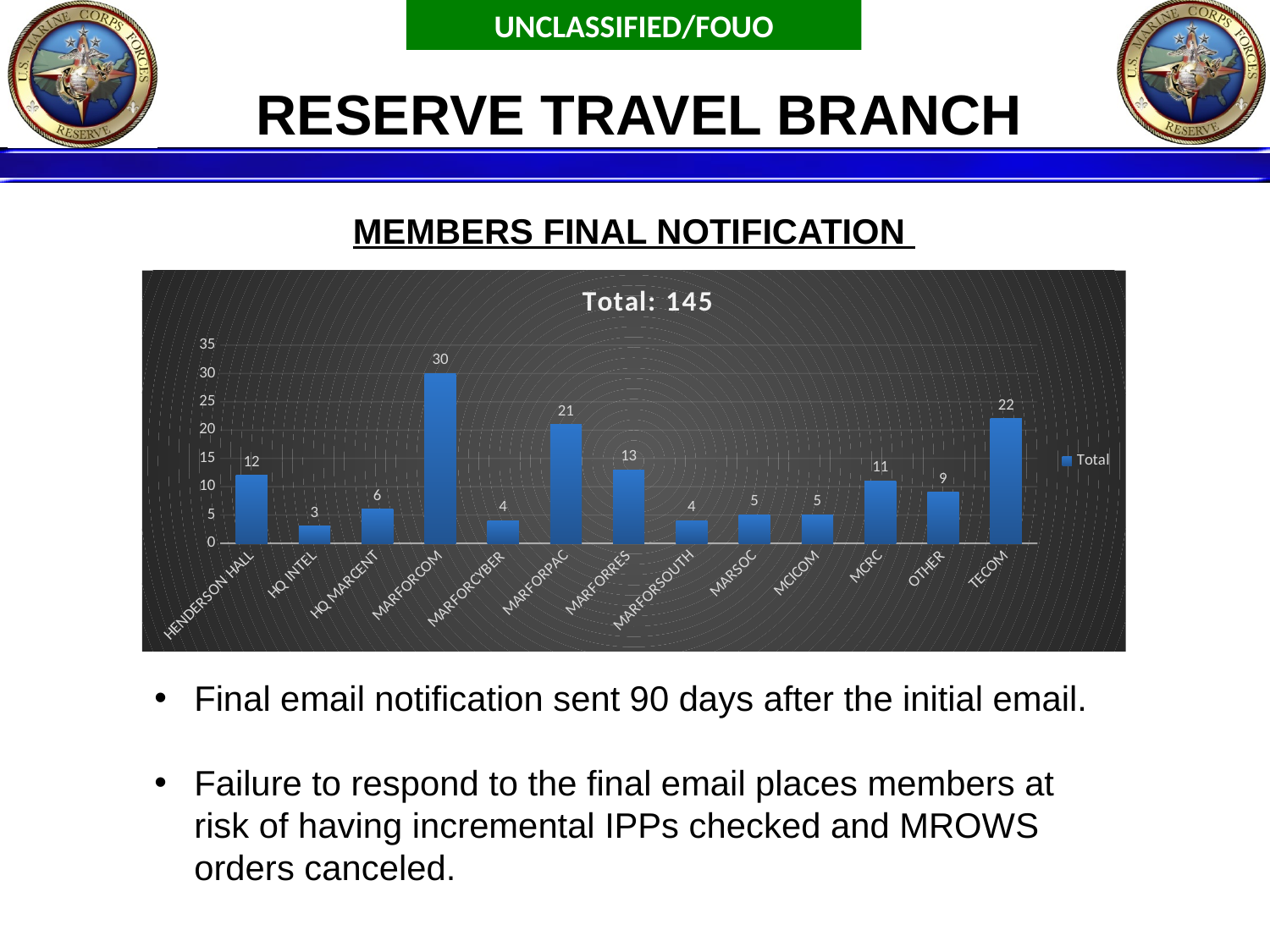
What kind of chart is shown on the slide? bar chart What is the value for HENDERSON HALL? 12 How many series does the legend list? 1 What is the value for TECOM? 22 What is the value for MARFORCOM? 30 Is the value for TECOM greater or less than 20? greater Which is larger, the value for MARFORRES or the value for MCRC? MARFORRES Which category has the lowest value? HQ INTEL How many categories are shown on the x axis? 13 What is the difference between the values for MARFORCOM and MARFORPAC? 9 Which category has the highest value? MARFORCOM What is the title of the chart? Total: 145